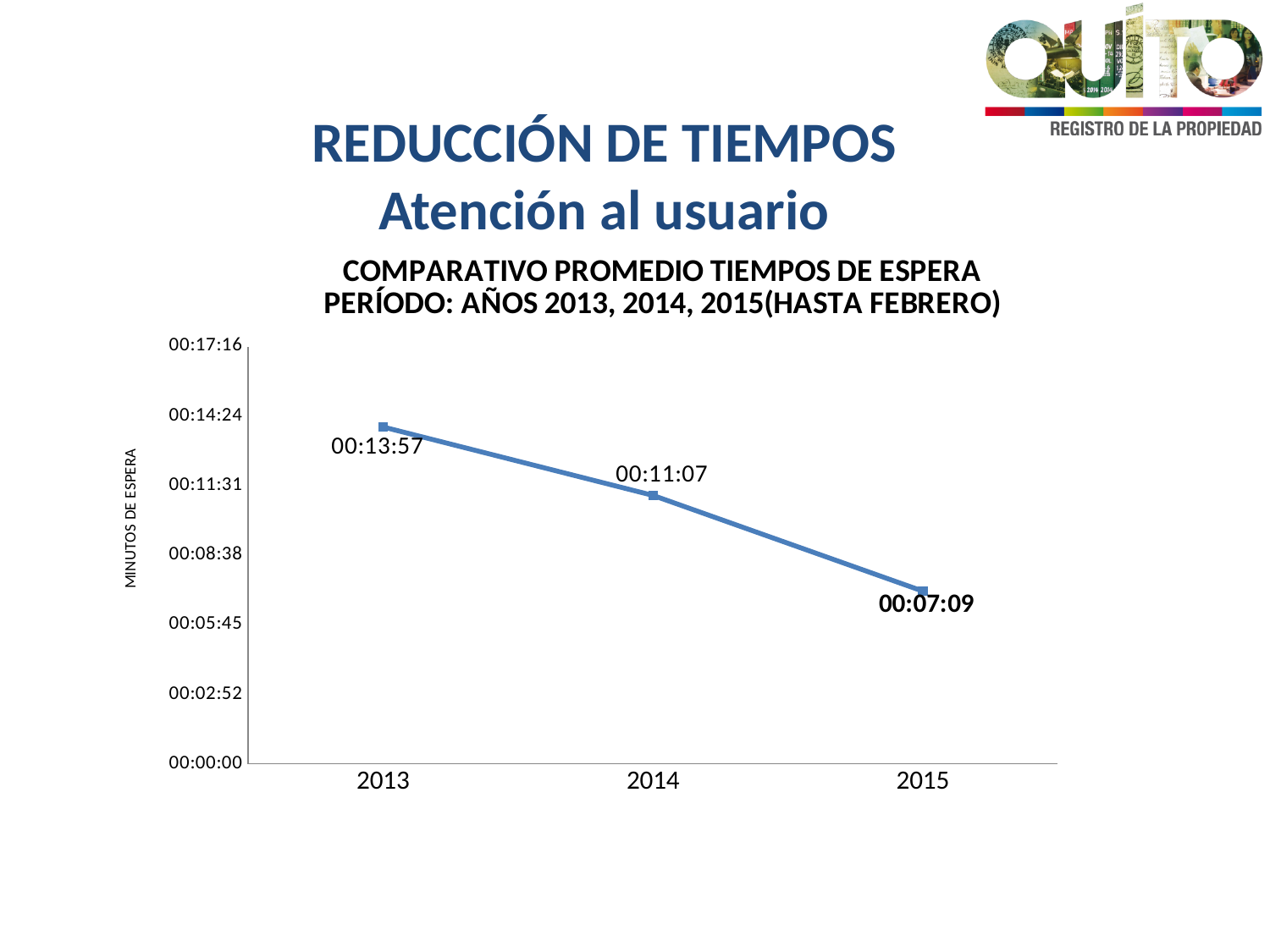
Which year has the highest average waiting time? 2013 What is the average waiting time shown for 2015? 00:07:09 What is the average waiting time shown for 2014? 00:11:07 What is the difference between the waiting times for 2014 and 2015? 00:03:58 Is the value for 2015 greater or less than 00:08:38? less Which year has a larger average waiting time, 2014 or 2015? 2014 Which year has the lowest average waiting time? 2015 What is the average waiting time shown for 2013? 00:13:57 How many years are plotted on the chart? 3 Do the waiting times rise or fall from 2013 to 2015? fall What is the difference between the waiting times for 2013 and 2014? 00:02:50 What kind of chart is shown on the slide? line chart